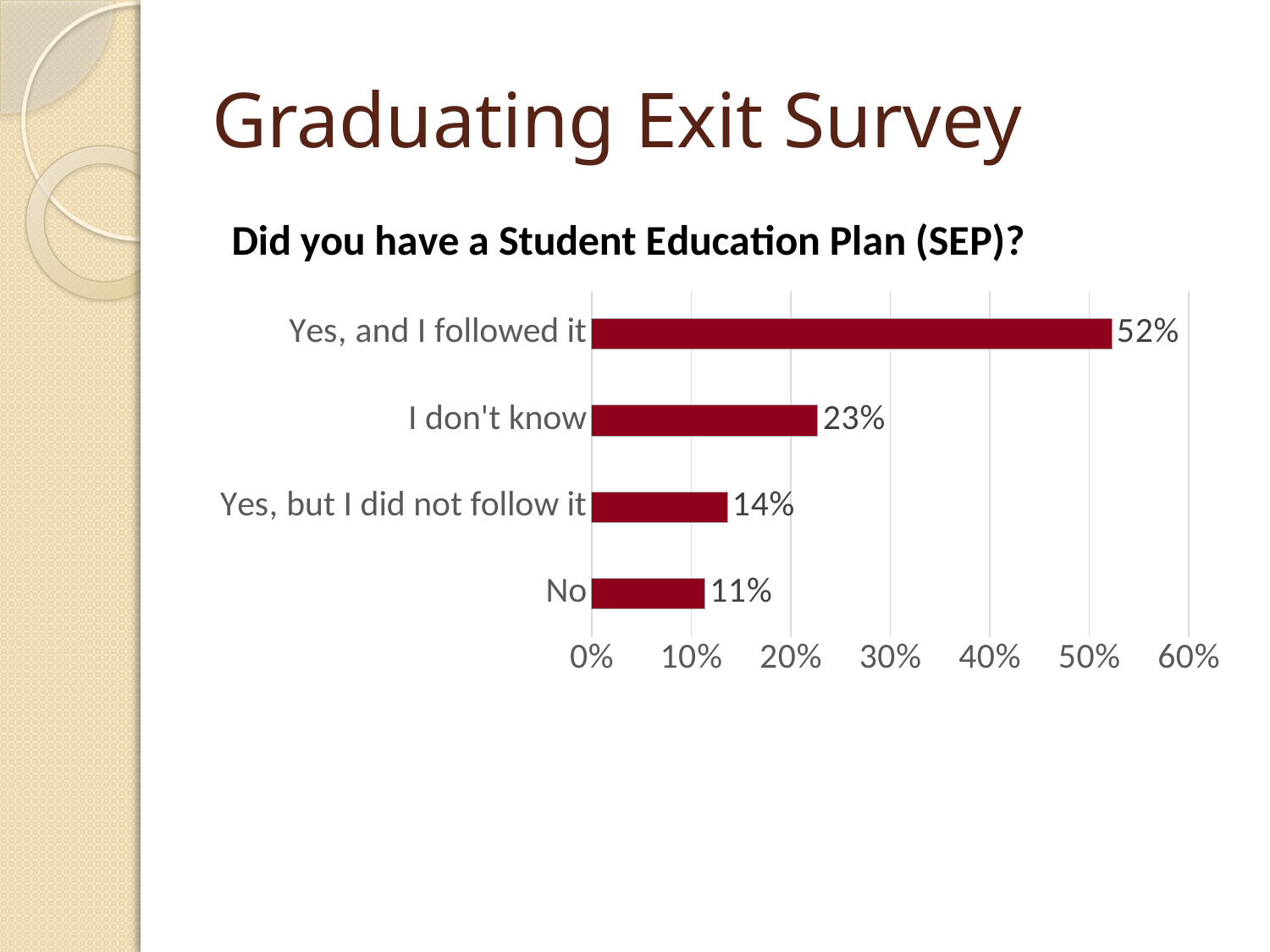
What question does the chart title ask? Did you have a Student Education Plan (SEP)? What is the difference in percentage points between "Yes, but I did not follow it" and "No"? 3% What is the difference in percentage points between "Yes, and I followed it" and "I don't know"? 29% What percentage of respondents answered "Yes, and I followed it"? 52% Which response has the lowest percentage? No Which is larger: the percentage for "I don't know" or for "Yes, but I did not follow it"? I don't know What percentage of respondents answered "No"? 11% What percentage of respondents answered "Yes, but I did not follow it"? 14% What type of chart is shown on the slide? Bar chart Which response has the highest percentage? Yes, and I followed it What percentage of respondents answered "I don't know"? 23% How many response categories are shown in the chart? 4